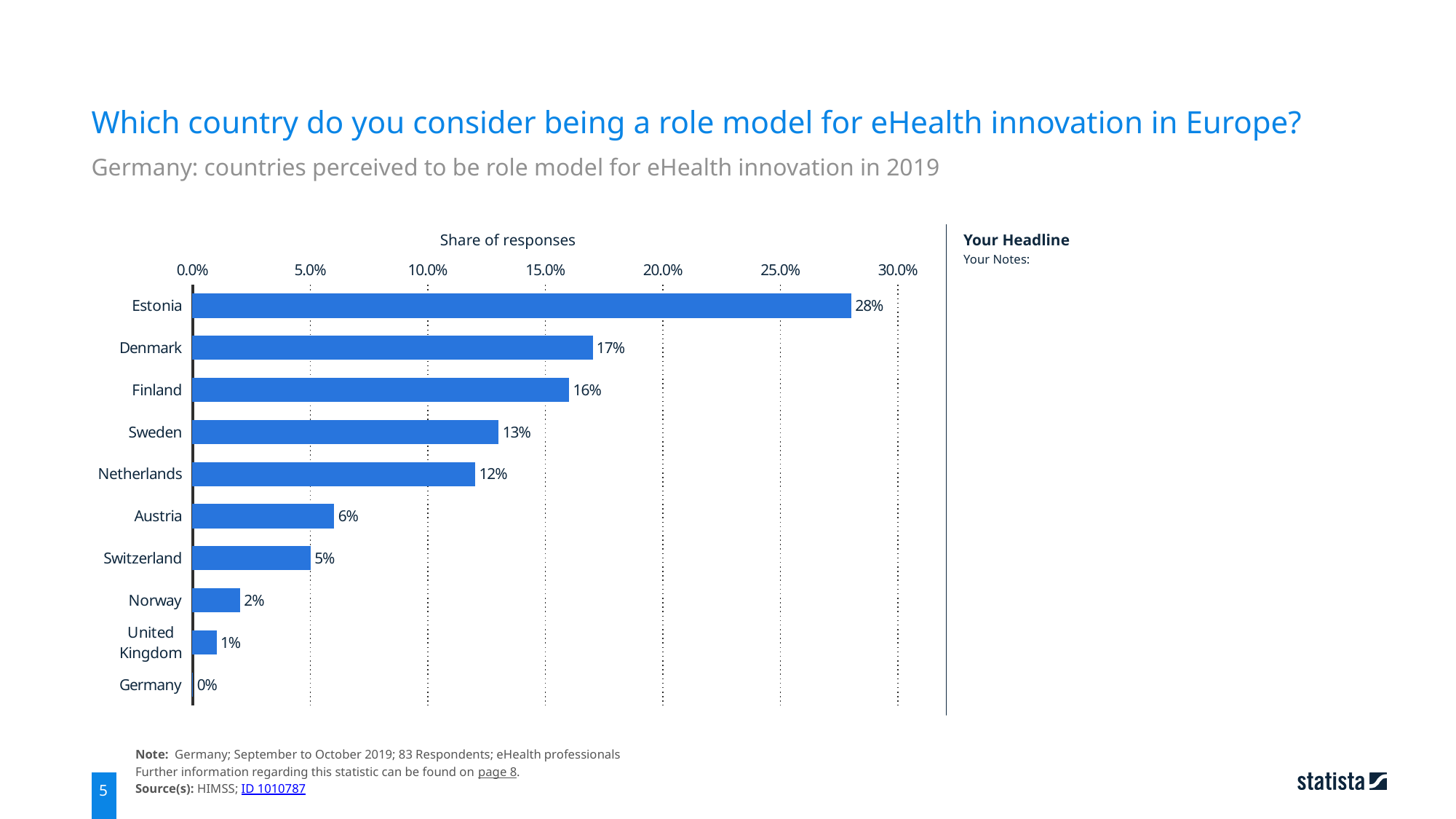
What share of responses does Switzerland have? 5% What kind of chart is shown on the slide? Bar chart Which has a larger share of responses, Finland or Sweden? Finland Which country has the lowest share of responses? Germany What is the difference in share of responses between Sweden and Austria? 7% Which country has the highest share of responses? Estonia What share of responses does Estonia have? 28% Is the value for Denmark greater or less than 15.0%? greater What is the axis title shown above the chart? Share of responses What share of responses does the Netherlands have? 12% What is the difference in share of responses between Estonia and Denmark? 11% How many countries are shown in the chart? 10